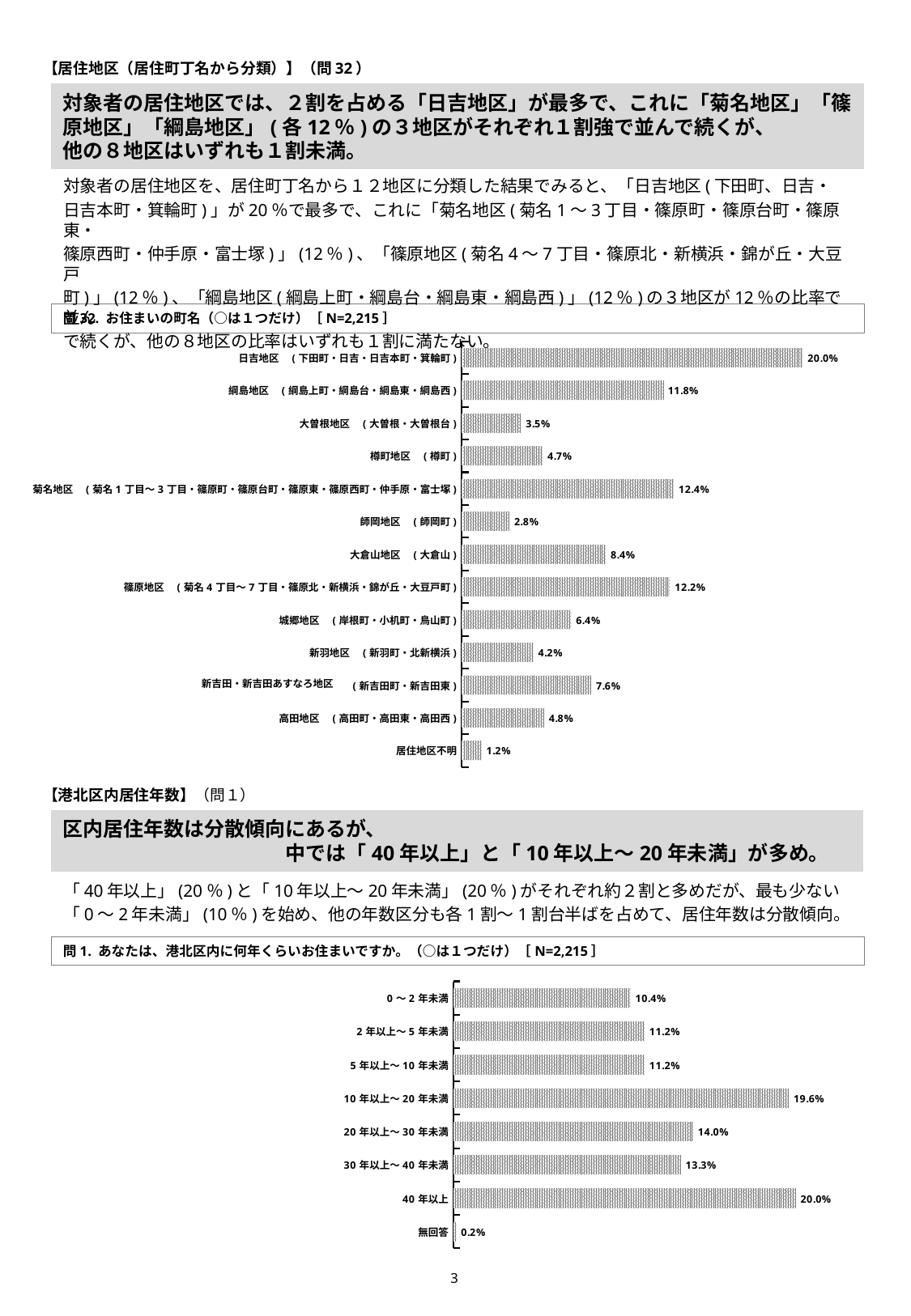
In the top chart (問32 お住まいの町名), which is larger, 綱島地区 or 城郷地区? 綱島地区 In the top chart (問32 お住まいの町名), which category has the lowest value? 居住地区不明 In the top chart (問32 お住まいの町名), what is the value for 大倉山地区? 8.4% What type of chart is the bottom chart (問1 港北区内居住年数)? Bar chart In the bottom chart (問1 港北区内居住年数), what is the value for 10年以上～20年未満? 19.6% In the top chart (問32 お住まいの町名), what is the difference between 菊名地区 and 篠原地区? 0.2% In the bottom chart (問1 港北区内居住年数), how many categories are plotted? 8 In the bottom chart (問1 港北区内居住年数), what is the difference between 20年以上～30年未満 and 30年以上～40年未満? 0.7% In the top chart (問32 お住まいの町名), which category has the highest value? 日吉地区 In the top chart (問32 お住まいの町名), what is the value for 日吉地区? 20.0% In the bottom chart (問1 港北区内居住年数), which category has the highest value? 40年以上 In the top chart (問32 お住まいの町名), how many categories are plotted? 13